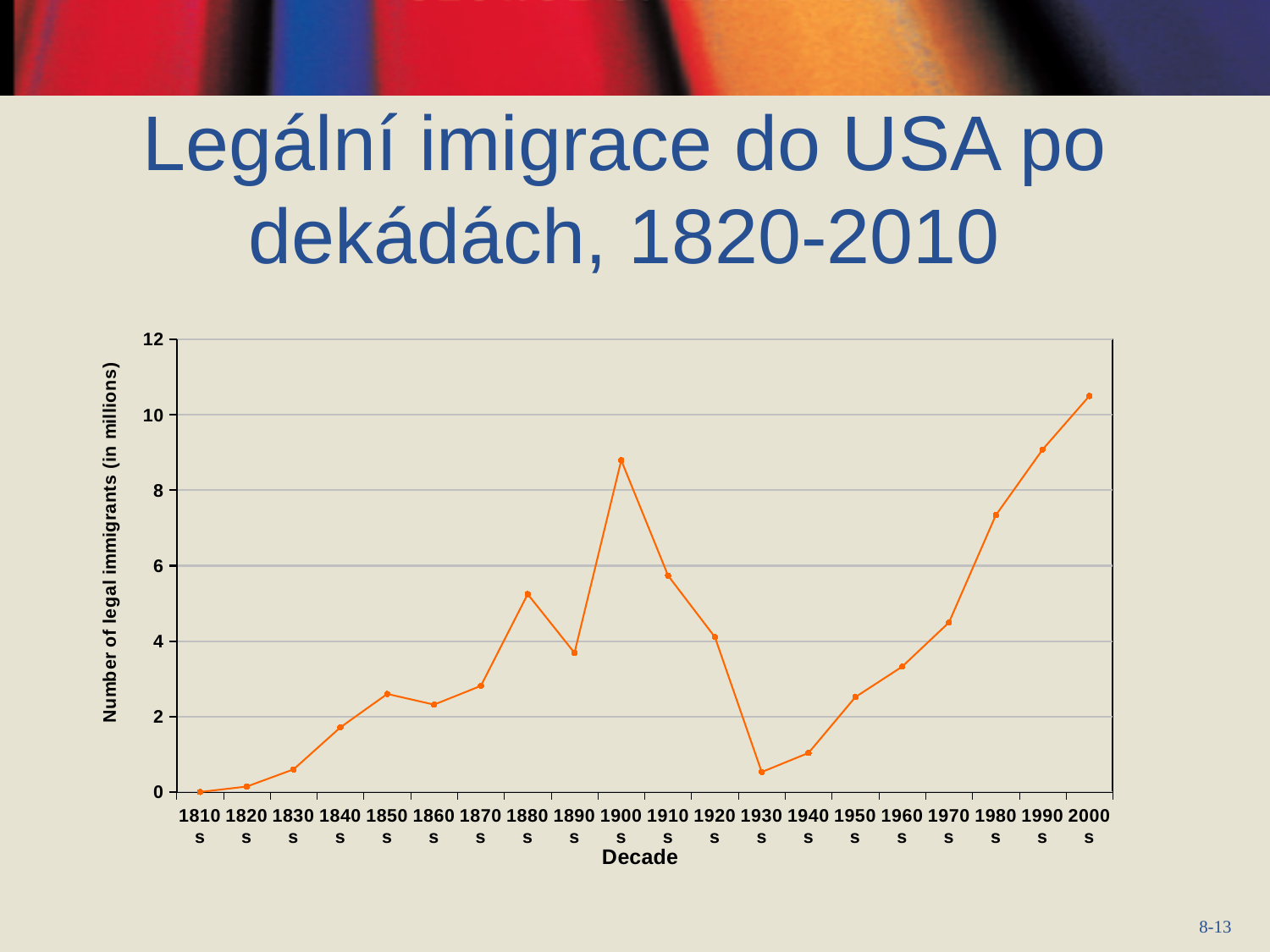
Is the value for the 1960s greater or less than 4? less Is the value for the 2000s greater or less than 10? greater What is the title of the vertical axis of the chart? Number of legal immigrants (in millions) Do the values rise or fall from the 1900s to the 1930s? fall Which decade has the highest number of legal immigrants in the chart? 2000s Do the values rise or fall from the 1930s to the 2000s? rise What kind of chart is shown on the slide? line chart Is the value for the 1900s greater or less than 8? greater Which decade has the lowest number of legal immigrants in the chart? 1810s Which decade has a higher value, the 1900s or the 1880s? 1900s How many decades are plotted on the x axis of the chart? 20